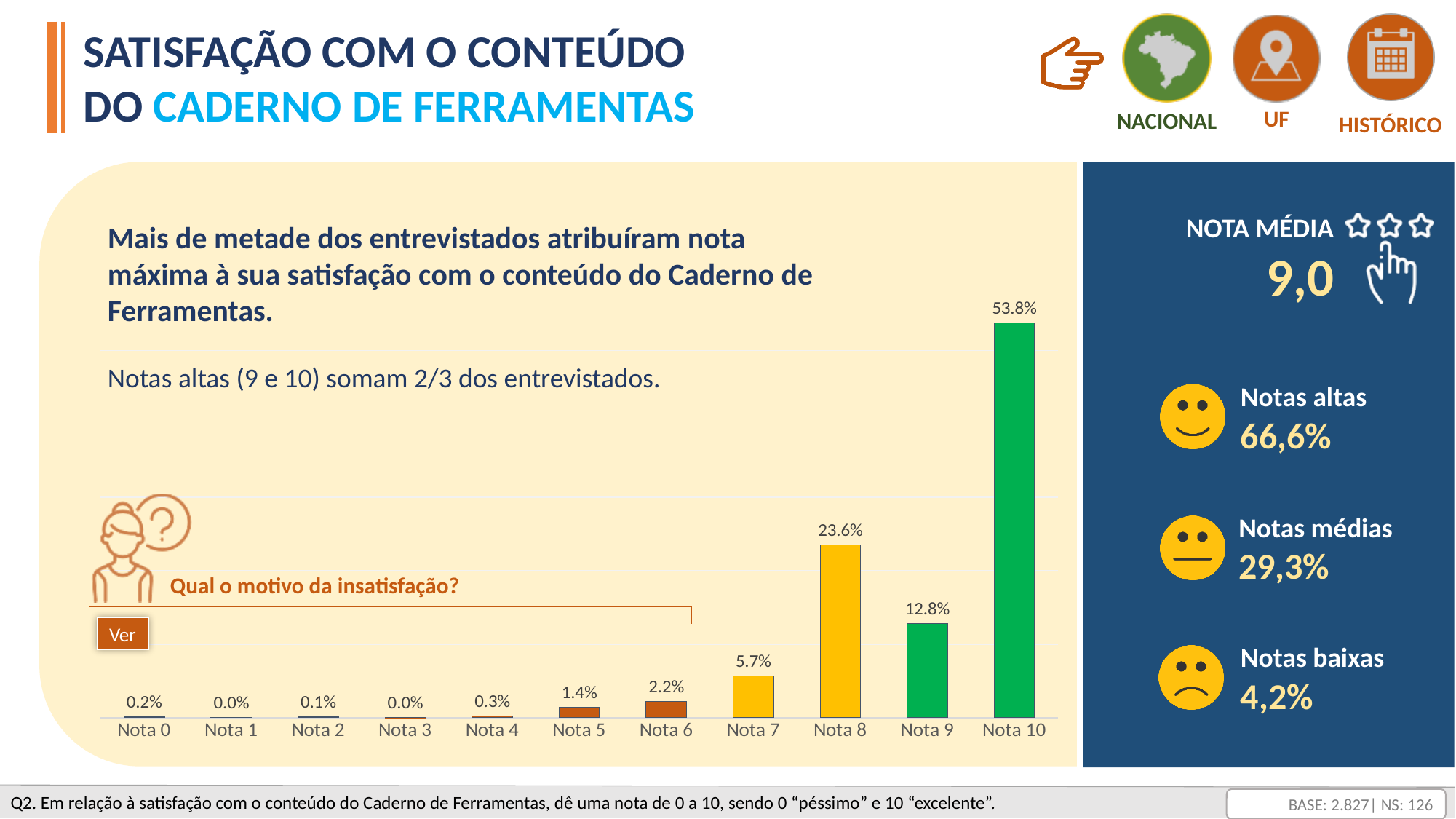
What colour are the bars for Nota 9 and Nota 10? Green What is the value for Nota 10? 53.8% What is the difference between the values for Nota 10 and Nota 8? 30.2% How many categories are shown on the x axis? 11 What is the difference between the values for Nota 9 and Nota 7? 7.1% What is the value for Nota 8? 23.6% What is the value for Nota 7? 5.7% What is the value for Nota 9? 12.8% What kind of chart is shown on the slide? Bar chart What is the value for Nota 5? 1.4% Which is larger, the value for Nota 8 or the value for Nota 9? Nota 8 Which category has the highest value? Nota 10